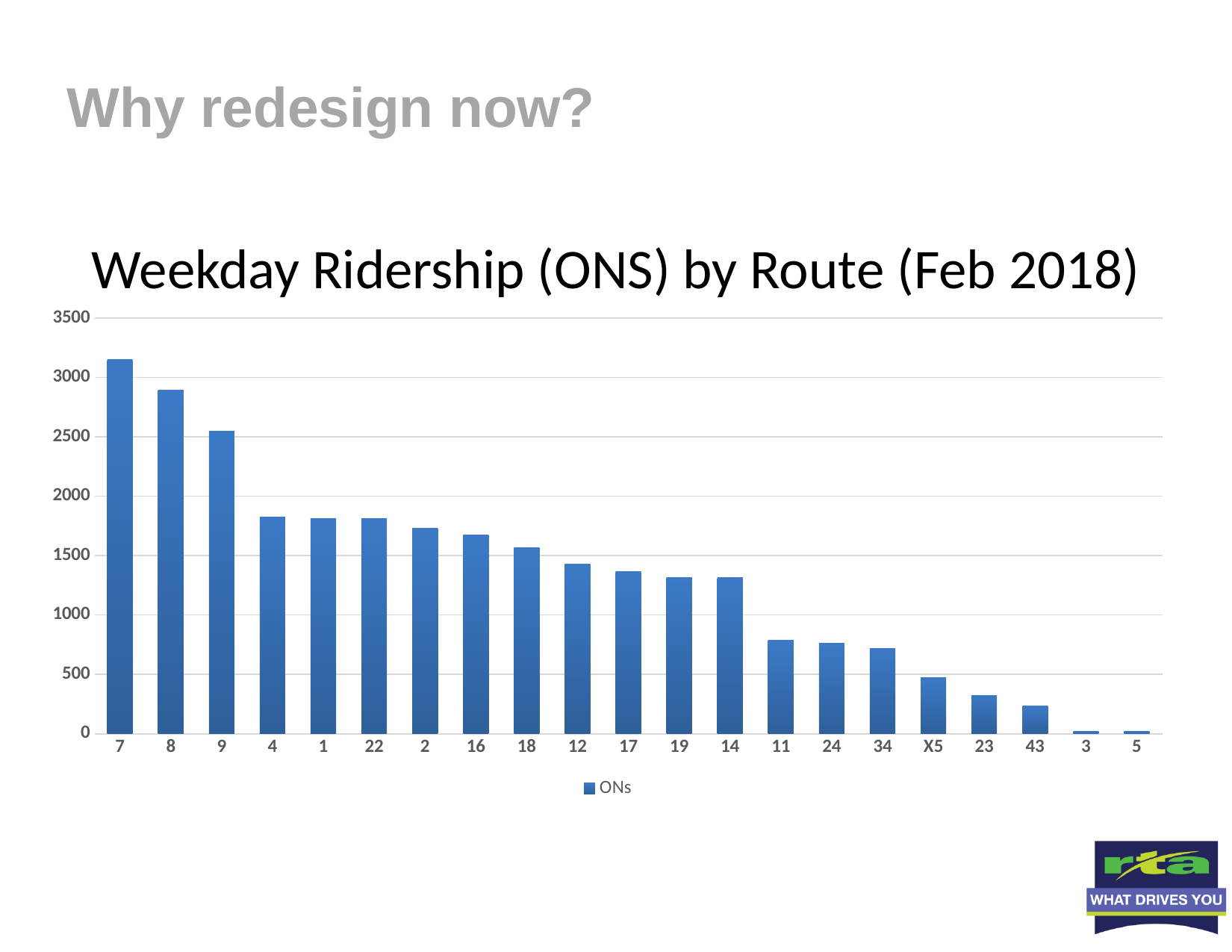
Is the value for route 7 greater or less than 3000? greater What type of chart is shown on the slide? bar chart Is the value for route 4 greater or less than 2000? less What is the title of the chart? Weekday Ridership (ONS) by Route (Feb 2018) Is the value for route 8 greater or less than 3000? less How many series does the legend list? 1 Do the ridership values rise or fall moving from left to right along the x axis? fall Which route has the highest weekday ridership? 7 Which route has the larger ridership, route 8 or route 9? 8 How many routes are shown on the x axis of the chart? 21